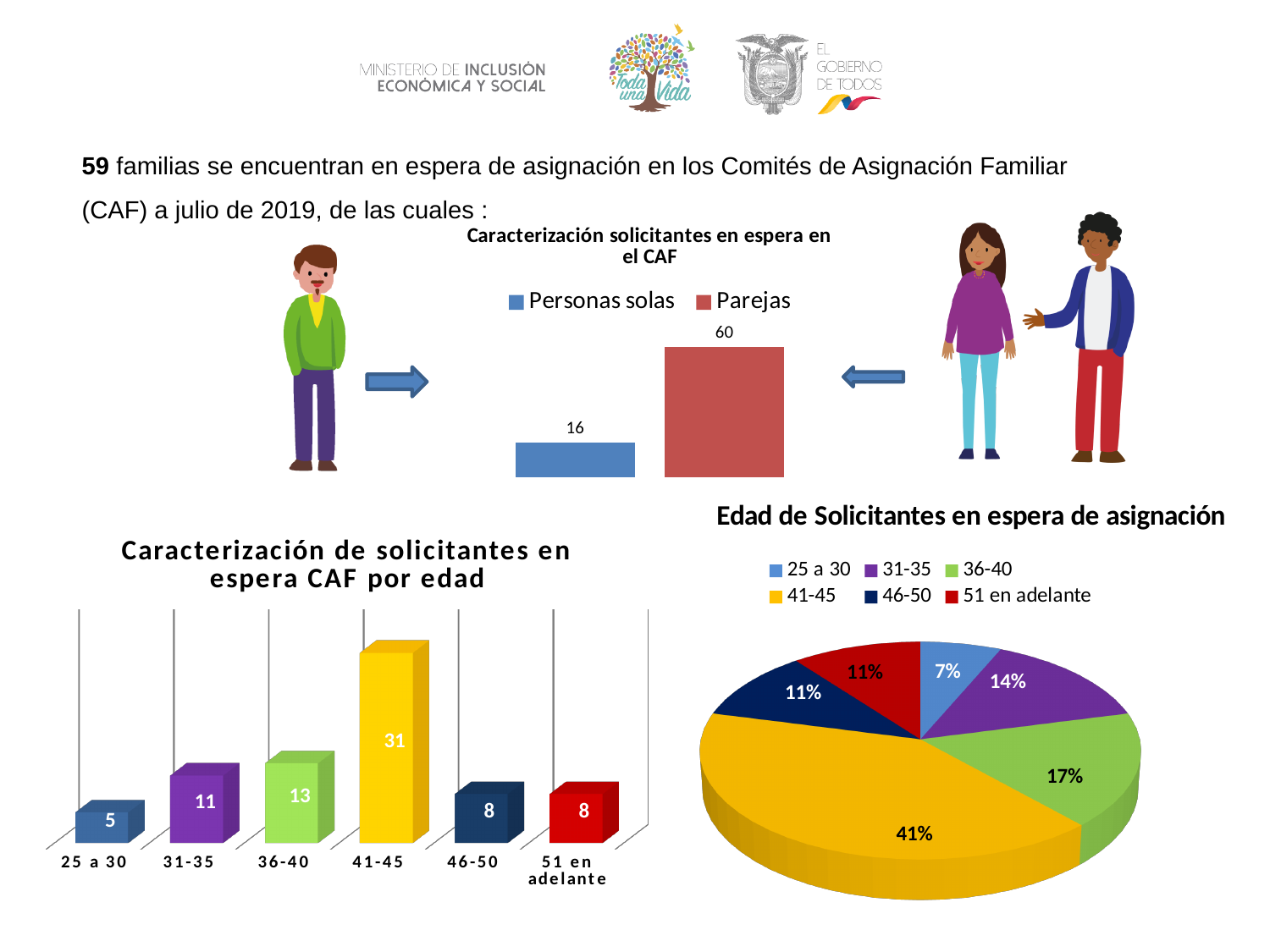
What kind of chart is 'Caracterización de solicitantes en espera CAF por edad'? Bar chart In the pie chart titled 'Edad de Solicitantes en espera de asignación', what share does 41-45 have? 41% In the chart titled 'Caracterización de solicitantes en espera CAF por edad', what is the value for 41-45? 31 In the chart titled 'Caracterización solicitantes en espera en el CAF', what is the difference between Parejas and Personas solas? 44 In the chart titled 'Caracterización solicitantes en espera en el CAF', how many series does the legend list? 2 In the chart titled 'Caracterización de solicitantes en espera CAF por edad', how many age categories are shown? 6 In the pie chart titled 'Edad de Solicitantes en espera de asignación', which is larger, 36-40 or 31-35? 36-40 In the chart titled 'Caracterización solicitantes en espera en el CAF', what is the value for Personas solas? 16 In the chart titled 'Caracterización de solicitantes en espera CAF por edad', which age group has the lowest value? 25 a 30 In the chart titled 'Caracterización de solicitantes en espera CAF por edad', what is the difference between 36-40 and 31-35? 2 In the chart titled 'Caracterización solicitantes en espera en el CAF', what is the value for Parejas? 60 In the pie chart titled 'Edad de Solicitantes en espera de asignación', what share does 25 a 30 have? 7%